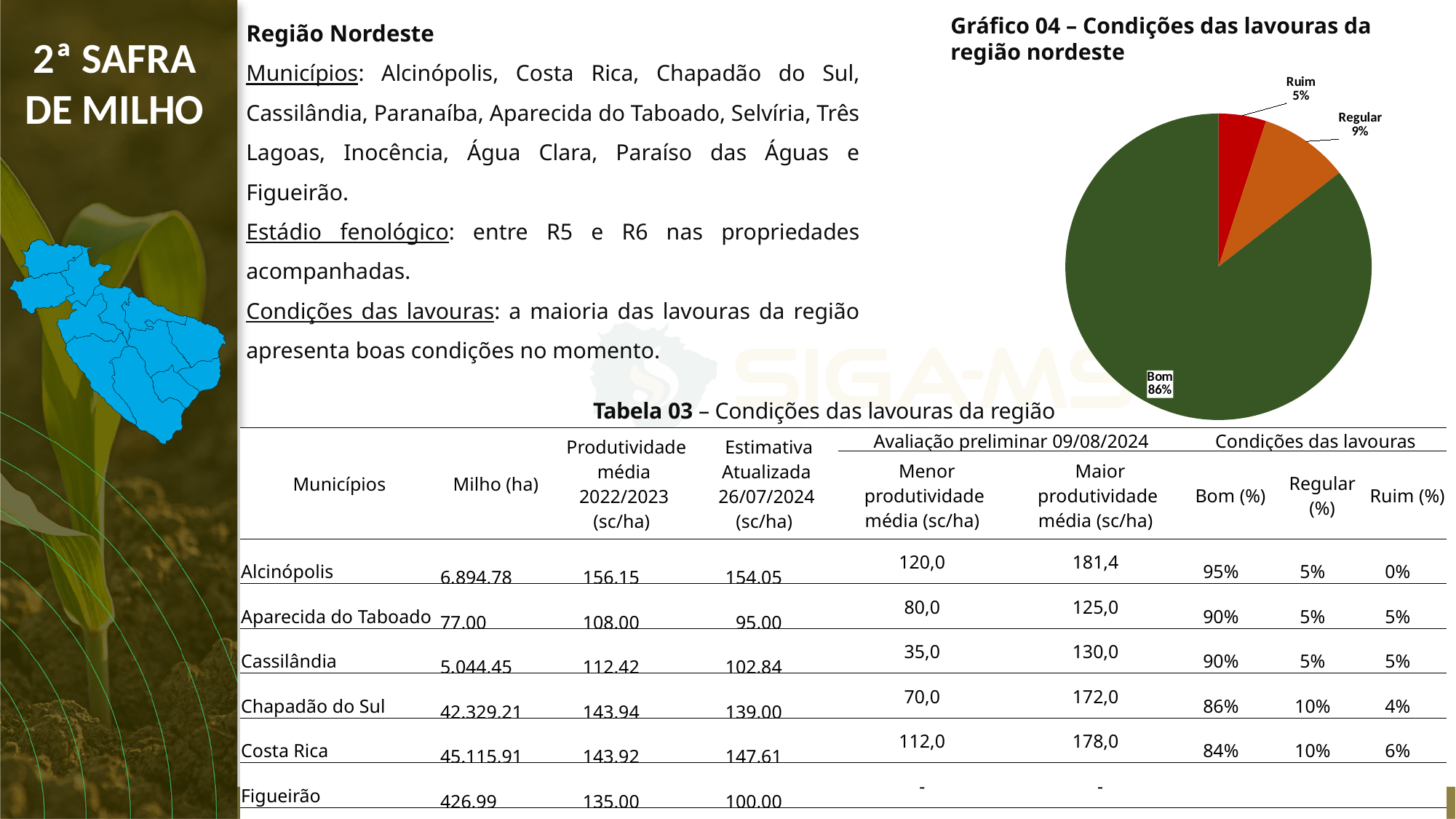
What percentage of the pie chart is labelled Regular? 9% What percentage of the pie chart is labelled Bom? 86% What is the difference in percentage points between the Regular and Ruim slices in the pie chart? 4 What colour is the Bom slice in the pie chart? Dark green Which category has the largest slice in the pie chart? Bom What percentage of the pie chart is labelled Ruim? 5% What type of chart is Gráfico 04? Pie chart What is the difference in percentage points between the Bom and Regular slices in the pie chart? 77 Which category has the smallest slice in the pie chart? Ruim In the pie chart, which is larger, Regular or Ruim? Regular What is the title of the chart on the slide? Gráfico 04 – Condições das lavouras da região nordeste How many slices does the pie chart have? 3